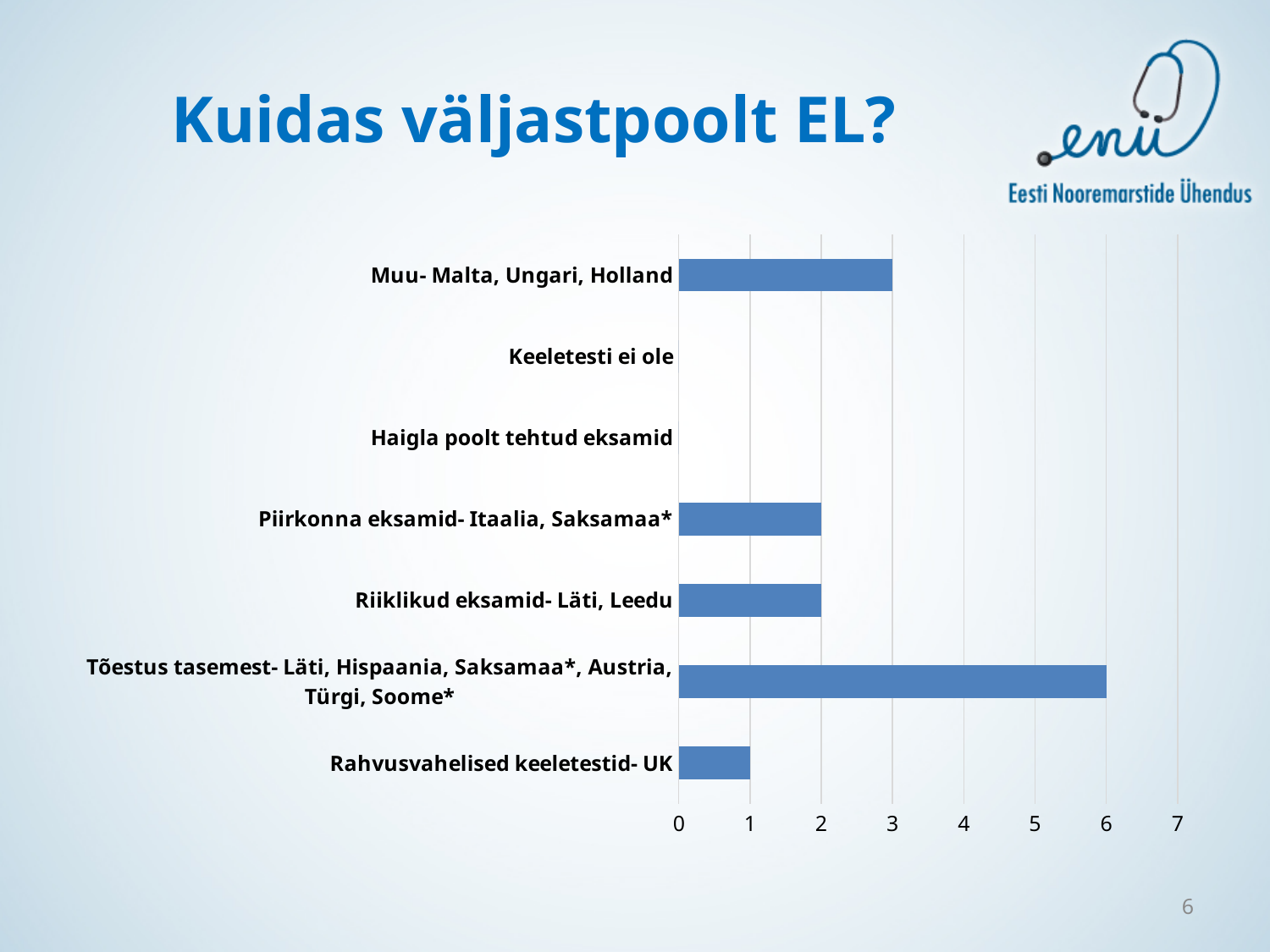
What is the value for "Muu- Malta, Ungari, Holland"? 3 What is the value for "Keeletesti ei ole"? 0 What type of chart is shown on the slide? bar chart What is the highest value shown on the horizontal axis? 7 What is the value for "Tõestus tasemest- Läti, Hispaania, Saksamaa*, Austria, Türgi, Soome*"? 6 Which is larger, the value for "Muu- Malta, Ungari, Holland" or the value for "Piirkonna eksamid- Itaalia, Saksamaa*"? Muu- Malta, Ungari, Holland Which category has the highest value? Tõestus tasemest- Läti, Hispaania, Saksamaa*, Austria, Türgi, Soome* Is the value for "Tõestus tasemest- Läti, Hispaania, Saksamaa*, Austria, Türgi, Soome*" greater or less than 5? greater What is the value for "Rahvusvahelised keeletestid- UK"? 1 What is the difference between the values for "Tõestus tasemest- Läti, Hispaania, Saksamaa*, Austria, Türgi, Soome*" and "Muu- Malta, Ungari, Holland"? 3 What is the value for "Riiklikud eksamid- Läti, Leedu"? 2 How many categories are shown on the chart? 7